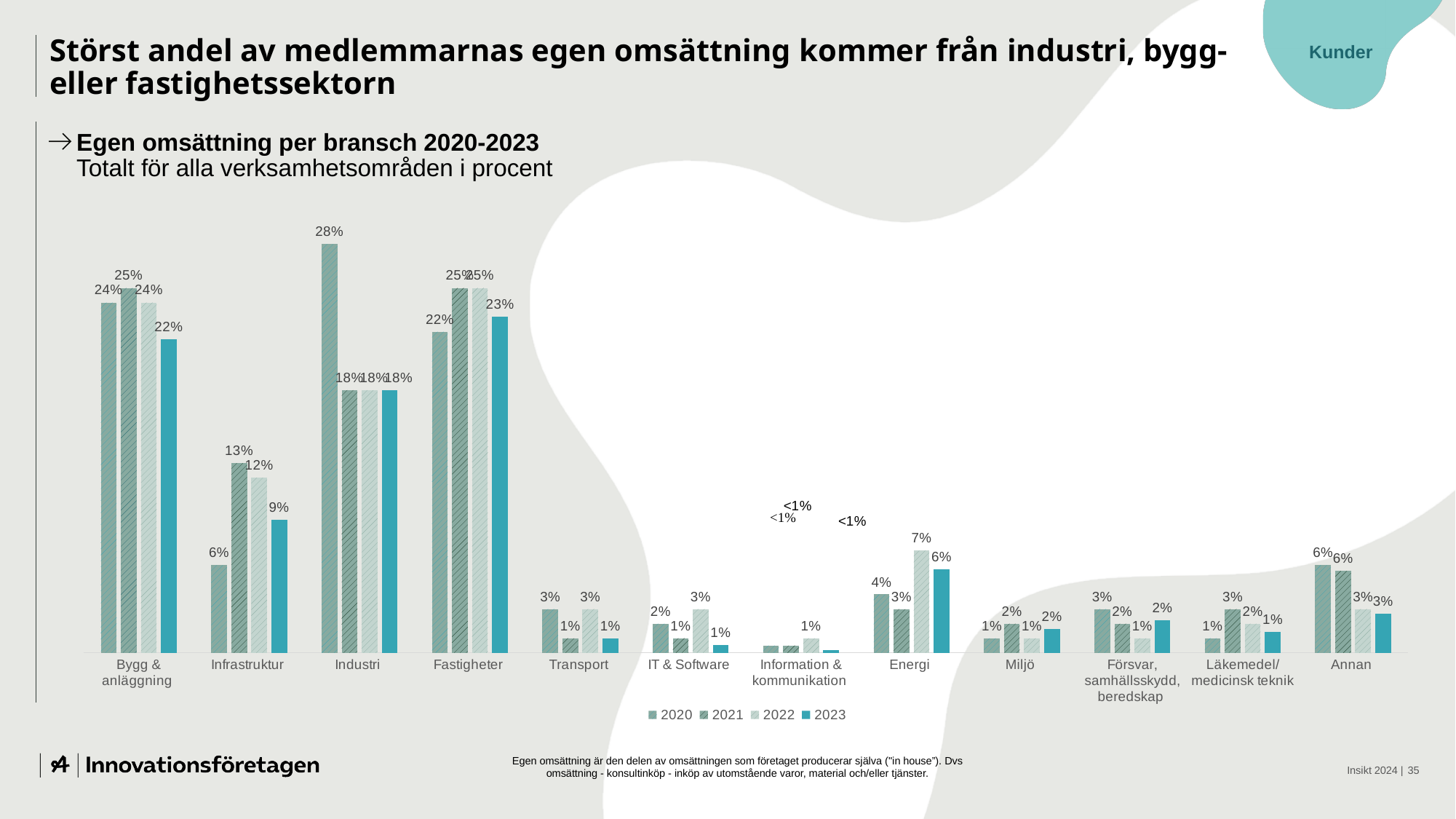
What is the value for Energi in 2022? 7% Which is larger for 2021: Infrastruktur or Annan? Infrastruktur Which category has the lowest value for 2020? Information & kommunikation Which category has the highest value for 2020? Industri What is the value for Annan in 2020? 6% What is the value for Infrastruktur in 2023? 9% How many series does the legend list? 4 What is the difference between the 2020 and 2021 values for Industri? 10 percentage points How many categories are shown on the x axis? 12 What is the value for Industri in 2020? 28% What kind of chart is shown on the slide? Bar chart Does the value for Infrastruktur rise or fall from 2021 to 2023? Fall